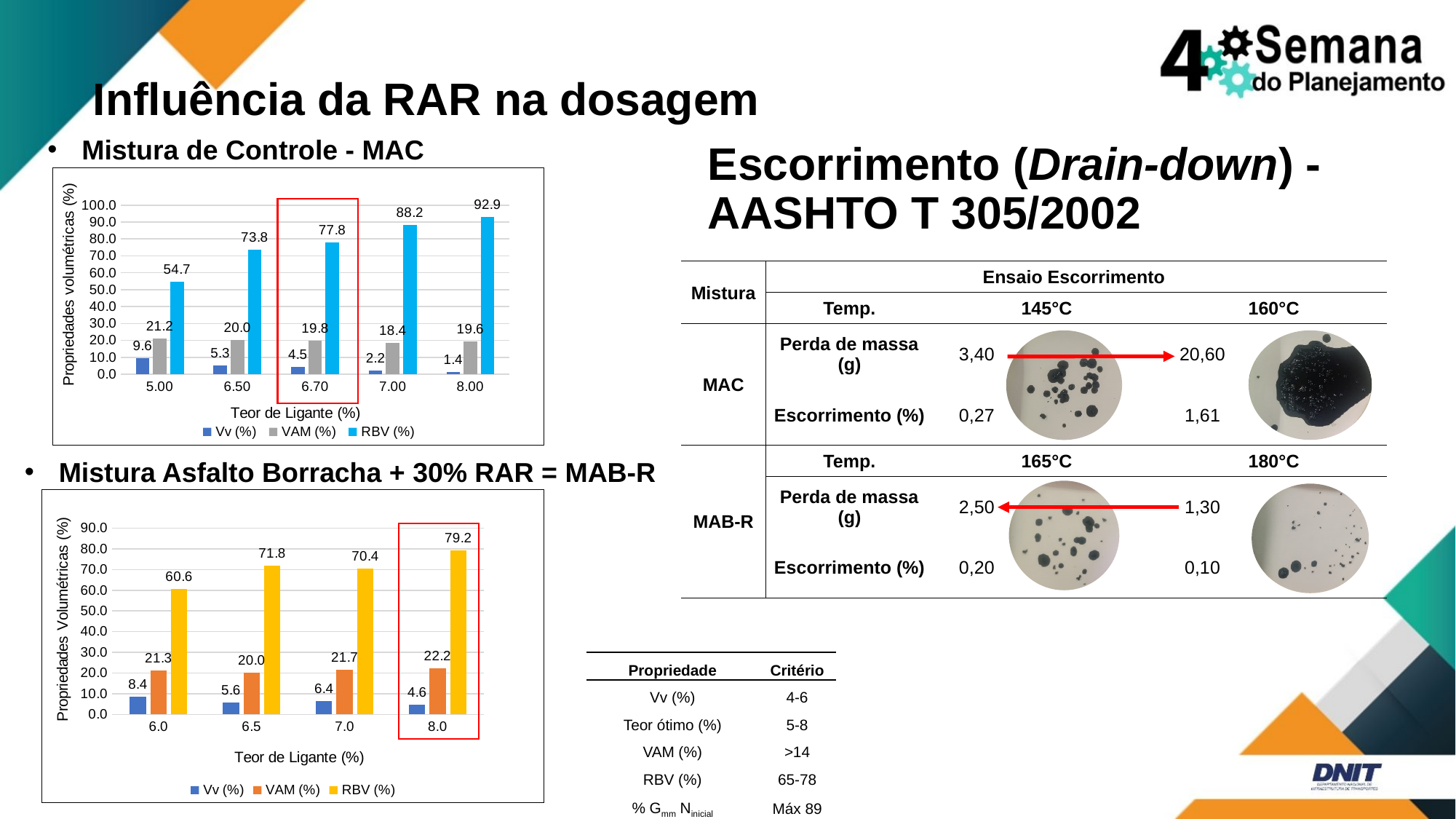
In the MAC chart (top), what is the difference between the RBV (%) values at 8.00 and 5.00? 38.2 In the MAC chart (top), at which binder content is Vv (%) lowest? 8.00 In the MAC chart (top), at which binder content is RBV (%) highest? 8.00 In the MAB-R chart (bottom), what is the RBV (%) value at a binder content of 8.0? 79.2 In the MAC chart (top), does RBV (%) rise or fall as binder content increases? rise In the MAB-R chart (bottom), what is the VAM (%) value at a binder content of 7.0? 21.7 In the MAB-R chart (bottom), which is larger: RBV (%) at 6.5 or RBV (%) at 7.0? RBV (%) at 6.5 In the MAC chart (top), what is the Vv (%) value at a binder content of 5.00? 9.6 What kind of chart is the MAB-R chart (bottom)? bar chart In the MAC chart (top), how many binder content categories are shown on the x axis? 5 In the MAB-R chart (bottom), how many series does the legend list? 3 In the MAC chart (top), what is the RBV (%) value at a binder content of 6.70? 77.8